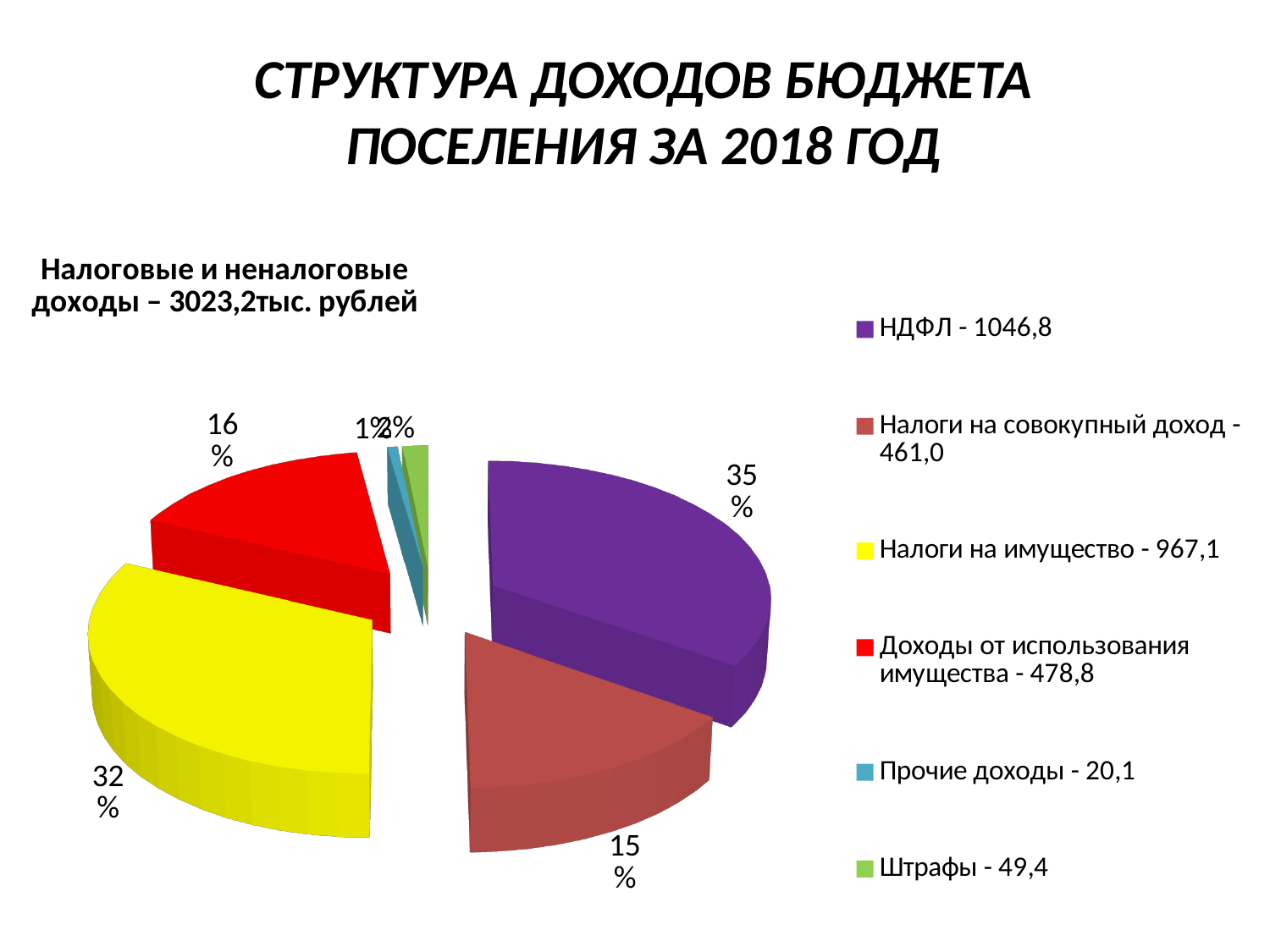
Which category has the smallest slice of the pie? Прочие доходы Which is larger: Налоги на имущество or Доходы от использования имущества? Налоги на имущество Which category has the largest slice of the pie? НДФЛ What share of the pie does Налоги на совокупный доход represent? 15% What is the difference between the values for НДФЛ (1046,8) and Налоги на имущество (967,1)? 79,7 According to the legend, what is the value for Штрафы? 49,4 According to the legend, what is the value for НДФЛ? 1046,8 What share of the pie does НДФЛ represent? 35% What kind of chart is shown on the slide? pie chart How many slices does the pie chart have? 6 What share of the pie does Доходы от использования имущества represent? 16%